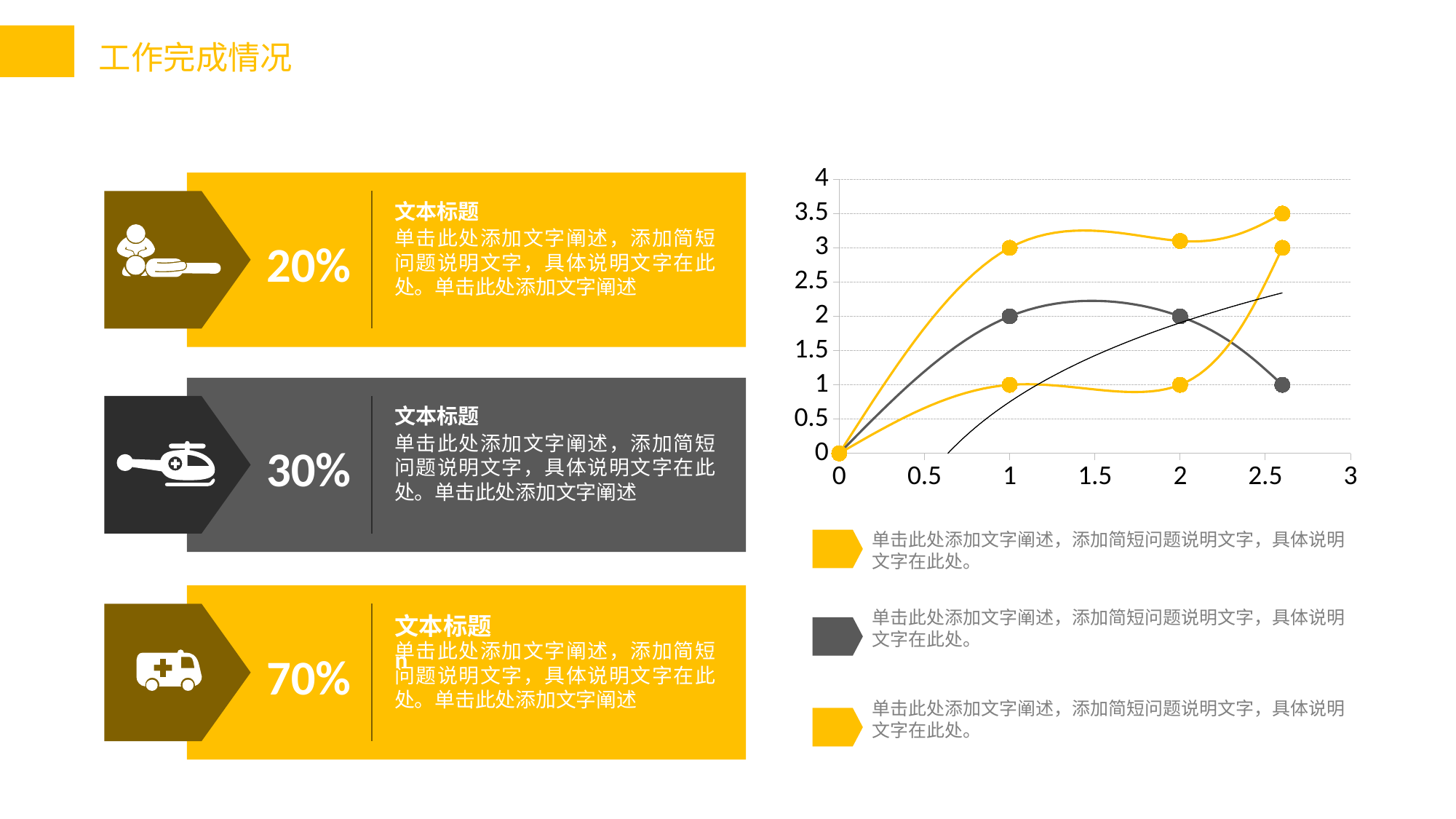
What is the value of the gray series at x = 1? 2 What is the value of the lower yellow series at x = 1? 1 What is the value of the upper yellow series at x = 1? 3 At x = 1, which is higher: the gray series or the lower yellow series? the gray series Does the gray series rise or fall between x = 2 and its last point? fall What is the value of the rightmost point of the gray series? 1 At x = 1, what is the difference between the upper yellow series and the gray series? 1 Which series reaches the highest point on the chart? the upper yellow series What is the highest value shown on the y axis? 4 What is the value of the gray series at x = 2? 2 What kind of chart is shown on the right of the slide? line chart